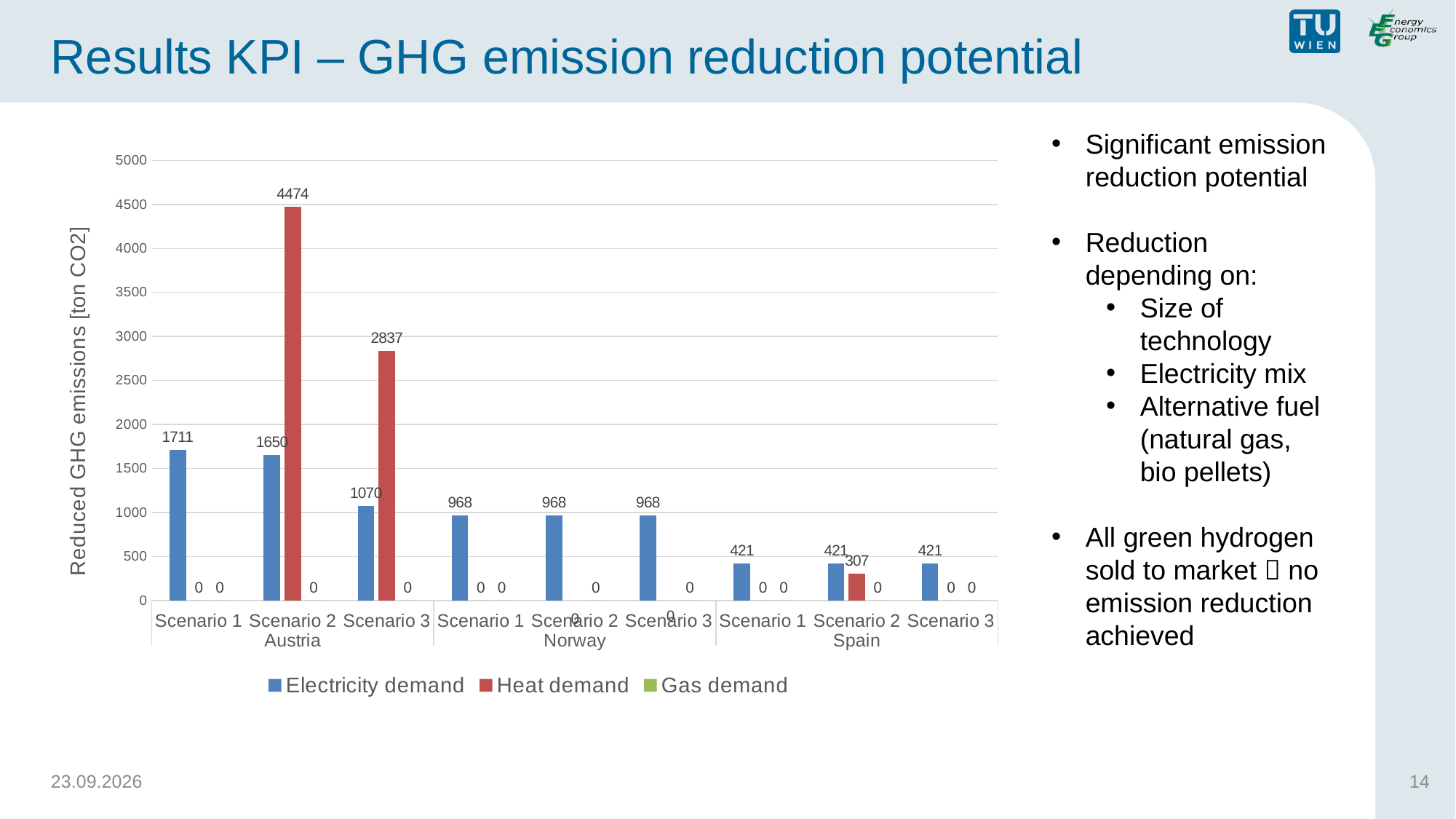
What type of chart is shown on the slide? bar chart What is the Heat demand value for Scenario 2 in Austria? 4474 What is the Electricity demand value for Scenario 1 in Austria? 1711 How many scenario categories are shown along the x axis? 9 How many series does the legend list? 3 Which bar has the highest value in the chart? Heat demand, Scenario 2, Austria What is the label of the y axis? Reduced GHG emissions [ton CO2] What is the Heat demand value for Scenario 2 in Spain? 307 Which is larger: the Electricity demand for Scenario 1 in Austria or for Scenario 2 in Austria? Scenario 1 in Austria What is the Heat demand value for Scenario 3 in Austria? 2837 What is the difference between the Heat demand values for Scenario 2 and Scenario 3 in Austria? 1637 What is the Electricity demand value for Scenario 3 in Norway? 968